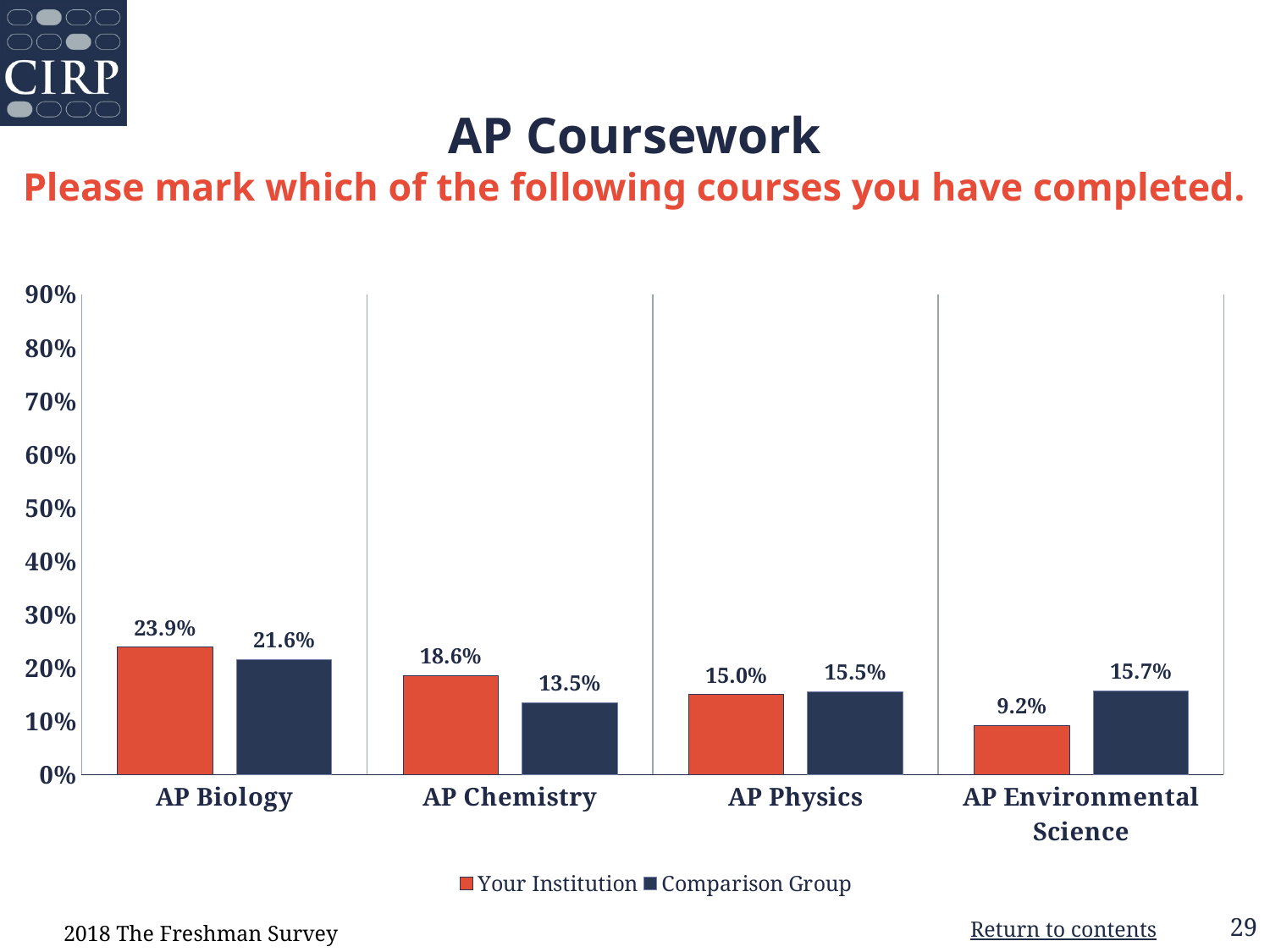
Is the Your Institution value for AP Biology greater or less than 20%? greater What is the Comparison Group value for AP Chemistry? 13.5% How many series does the legend list? 2 What kind of chart is shown on the slide? Bar chart What is the difference between the Comparison Group and Your Institution values for AP Environmental Science? 6.5% How many courses are shown on the x axis? 4 For AP Physics, which is larger: Your Institution or Comparison Group? Comparison Group Which course has the lowest Comparison Group value? AP Chemistry What is the difference between the Your Institution and Comparison Group values for AP Chemistry? 5.1% Which course has the highest Your Institution value? AP Biology What is the Your Institution value for AP Environmental Science? 9.2% What percentage of Your Institution students completed AP Biology? 23.9%